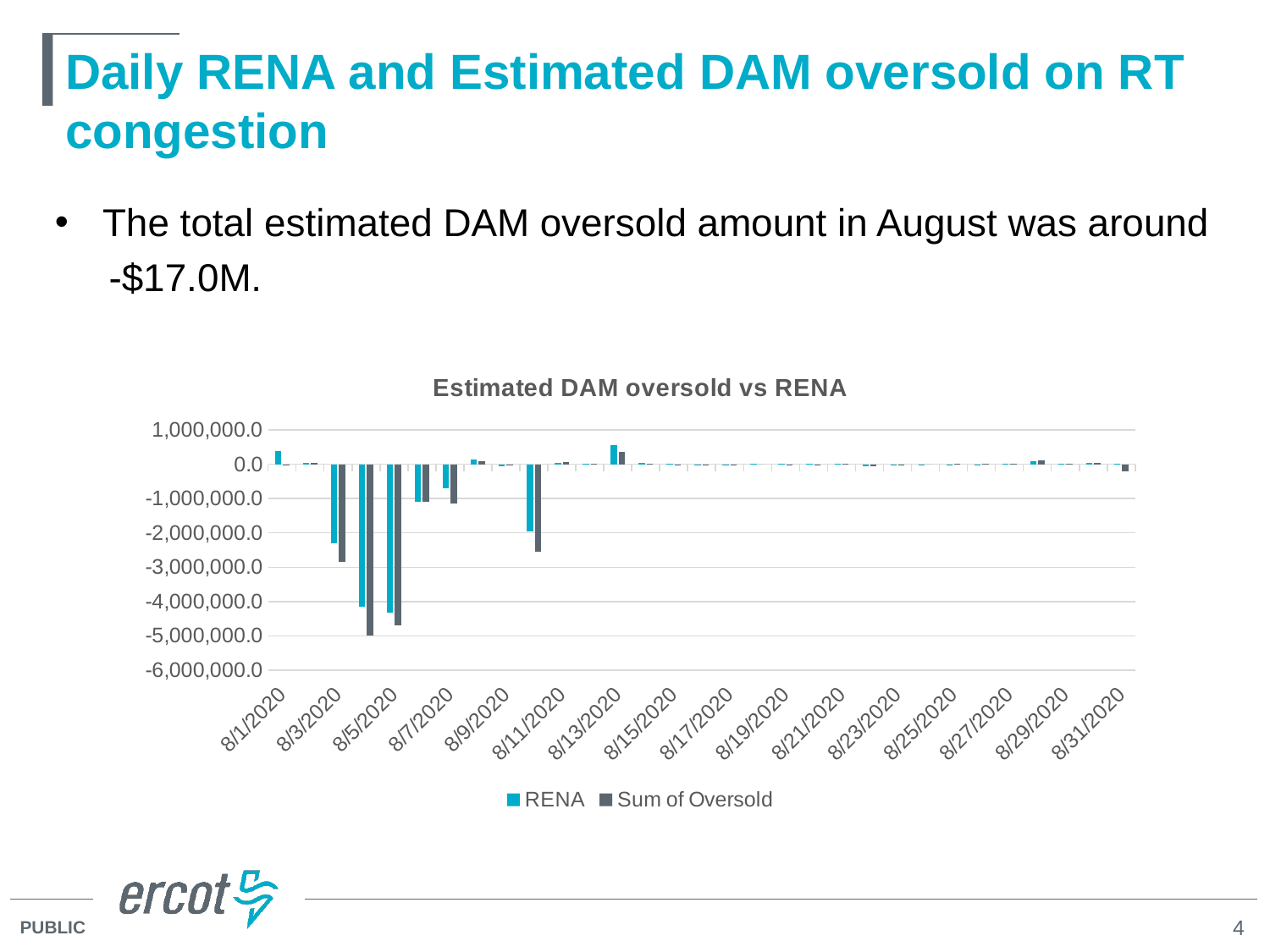
What kind of chart is shown on the slide? Bar chart What is the title of the chart? Estimated DAM oversold vs RENA Is the RENA value for 8/1/2020 greater or less than 0.0? greater Is the Sum of Oversold value for 8/13/2020 greater or less than 0.0? greater Is the Sum of Oversold value for 8/5/2020 greater or less than -4,000,000.0? less How many date labels are shown along the x axis of the chart? 16 How many series does the legend of the chart list? 2 Which has the larger Sum of Oversold value, 8/3/2020 or 8/5/2020? 8/3/2020 What are the two series named in the chart legend? RENA and Sum of Oversold